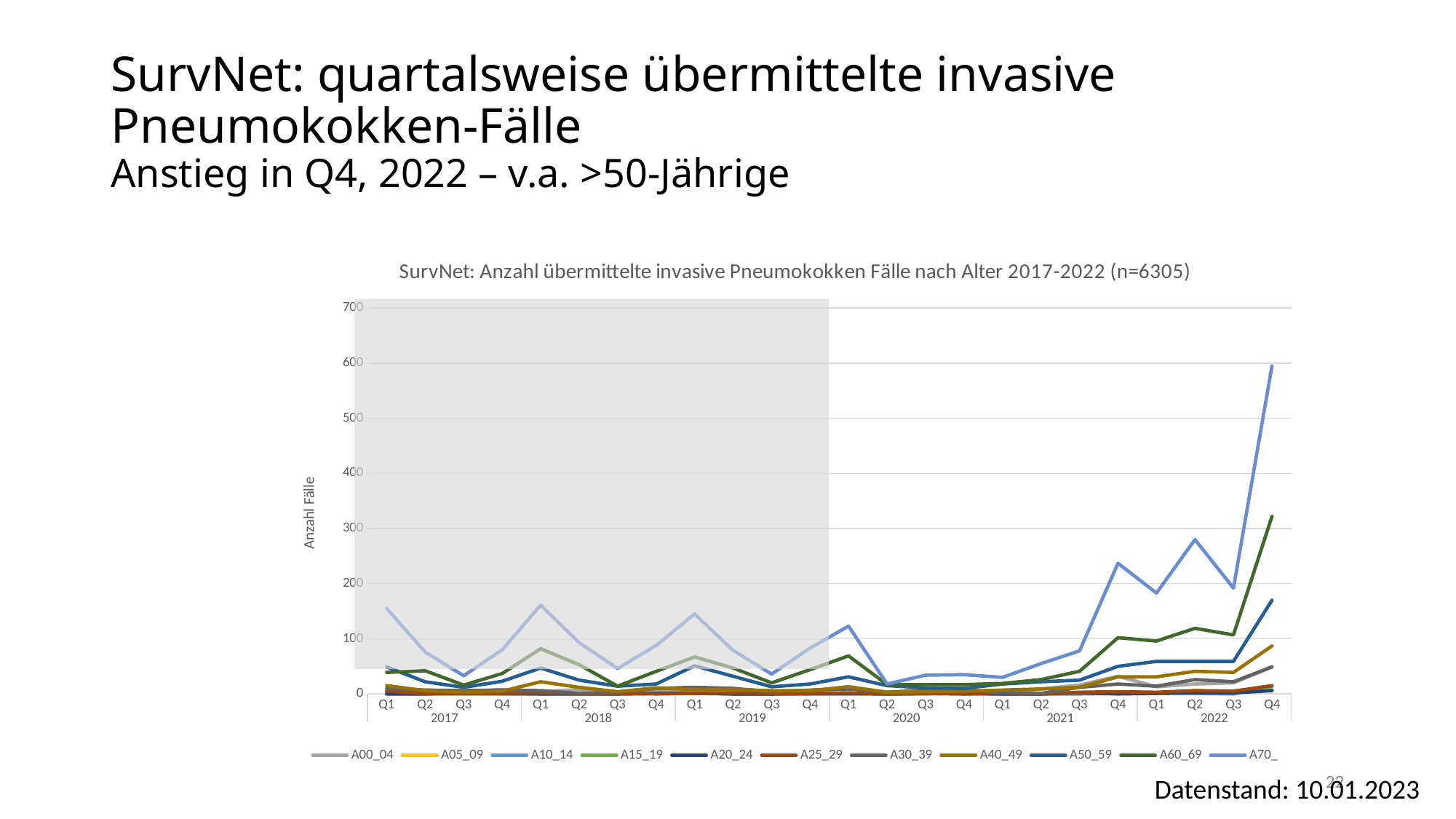
Which series has the highest value in Q4 2022? A70_ Is the value for A70_ in Q2 2020 greater or less than 100? less Is the value for A70_ in Q2 2022 greater or less than 200? greater Is the value for A60_69 in Q4 2022 greater or less than 200? greater What kind of chart is shown on the slide? line chart What is the title of the chart? SurvNet: Anzahl übermittelte invasive Pneumokokken Fälle nach Alter 2017-2022 (n=6305) Does the A70_ series rise or fall from Q3 2022 to Q4 2022? rise Which is larger in Q4 2022, the value for A70_ or the value for A50_59? A70_ How many series does the legend list? 11 How many quarterly data points are plotted along the x axis? 24 What is the label of the y axis? Anzahl Fälle